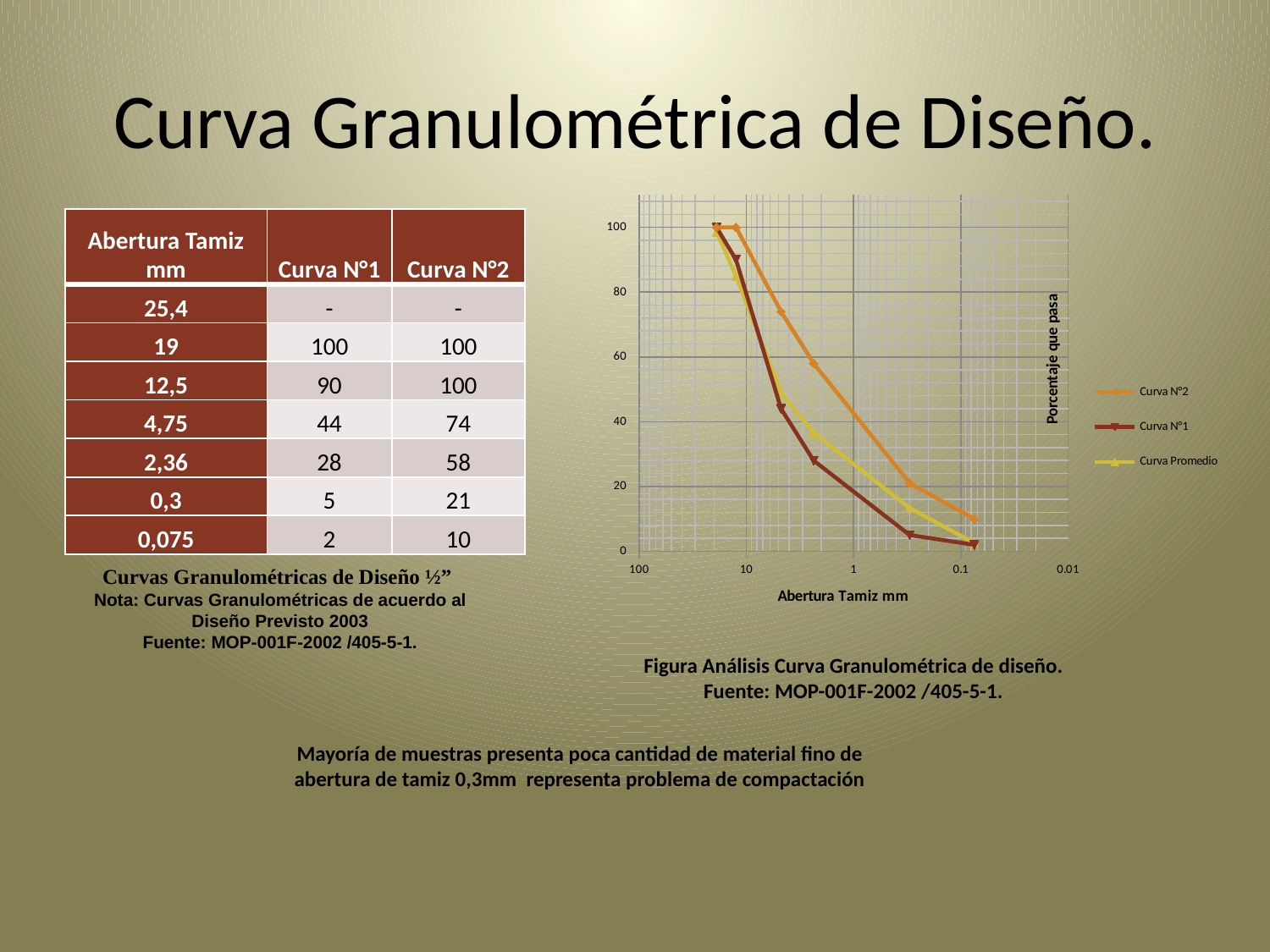
What is the title of the chart's x axis? Abertura Tamiz mm Is the value of Curva Promedio at 0.075 mm greater or less than 20? less Is the value of Curva N°1 at 2.36 mm greater or less than 40? less Do the plotted values rise or fall as you move from left to right along the x axis? fall Which series has the highest value at 0.3 mm? Curva N°2 Is the value of Curva N°2 at 4.75 mm greater or less than 60? greater How many series does the chart legend list? 3 At 2.36 mm, which series has the higher value, Curva N°1 or Curva N°2? Curva N°2 What is the value of Curva N°1 at 19 mm? 100 What kind of chart is shown on the slide? line chart What are the three series named in the chart legend? Curva N°2, Curva N°1, Curva Promedio